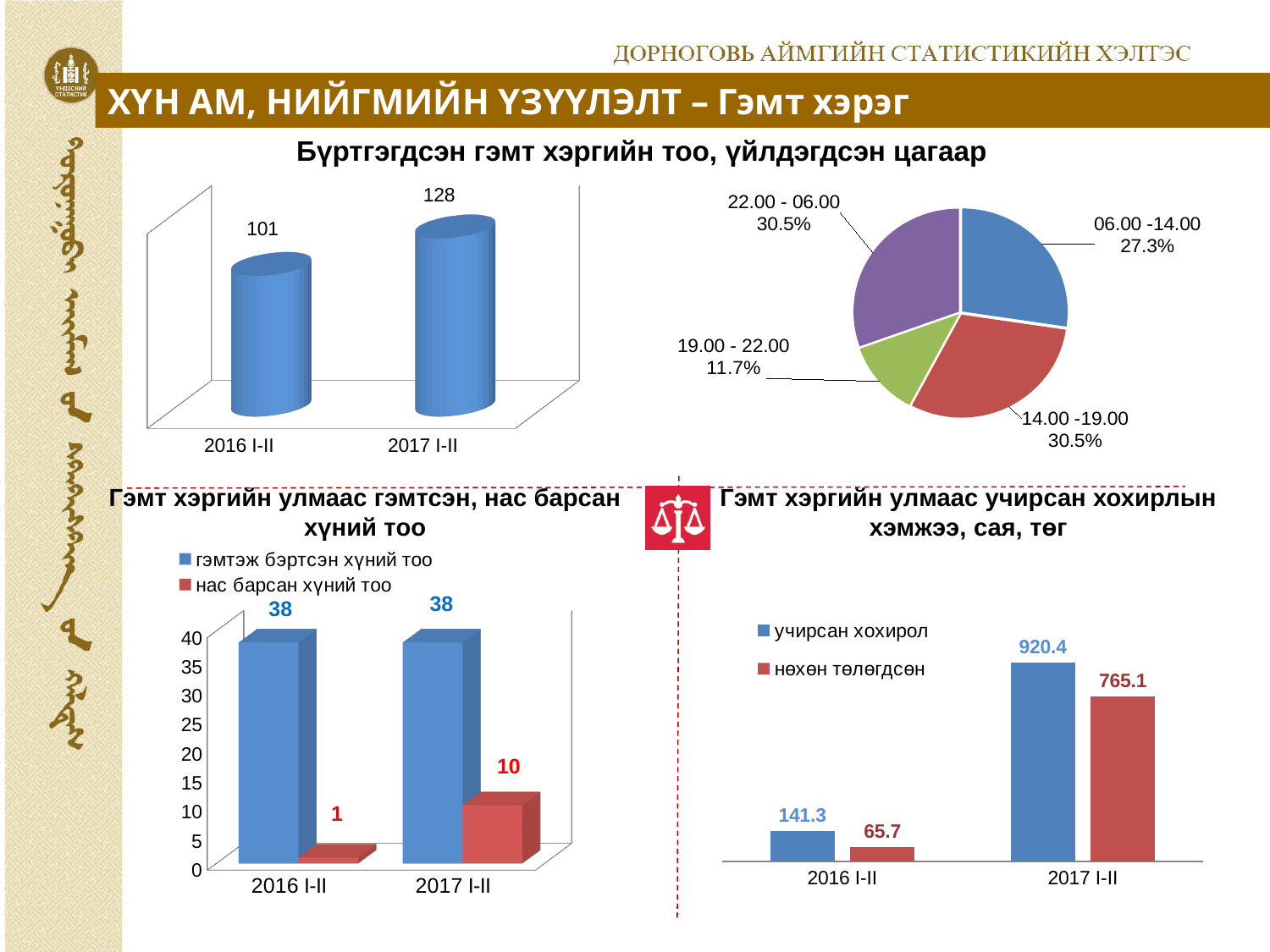
In the top-right pie chart, which time period has the smallest share? 19.00 - 22.00 What type of chart is the top-right chart on the slide? pie chart How many slices does the top-right pie chart have? 4 How many series does the legend of the bottom-left chart list? 2 In the bottom-right chart (Гэмт хэргийн улмаас учирсан хохирлын хэмжээ), what is the value of учирсан хохирол for 2017 I-II? 920.4 In the bottom-right chart, what is the difference between учирсан хохирол and нөхөн төлөгдсөн for 2016 I-II? 75.6 In the bottom-left chart (Гэмт хэргийн улмаас гэмтсэн, нас барсан хүний тоо), what is the value of нас барсан хүний тоо for 2017 I-II? 10 In the top-left bar chart (Бүртгэгдсэн гэмт хэргийн тоо), what is the value for 2017 I-II? 128 In the top-left bar chart (Бүртгэгдсэн гэмт хэргийн тоо), what is the value for 2016 I-II? 101 In the top-right pie chart, what share is shown for the 19.00 - 22.00 slice? 11.7% In the bottom-left chart, what is the value of гэмтэж бэртсэн хүний тоо for 2016 I-II? 38 In the top-left bar chart, by how much did the number of registered crimes change from 2016 I-II to 2017 I-II? 27